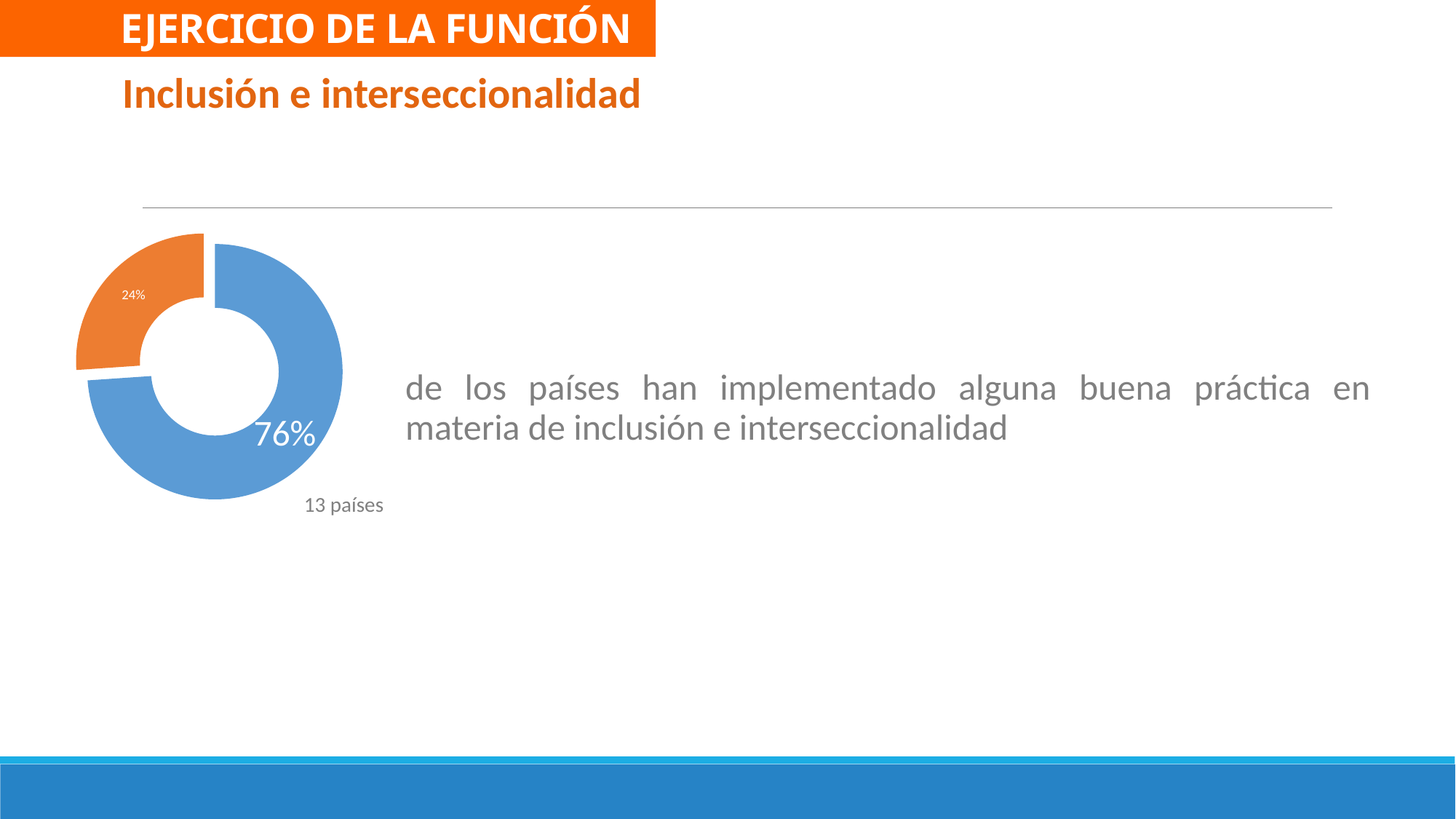
What percentage is shown on the blue slice of the doughnut chart? 76% Which slice of the doughnut chart is the largest? the blue slice (76%) What share of the doughnut does the orange slice represent? 24% How many slices does the doughnut chart have? 2 What is the total of the two slice percentages in the doughnut chart? 100% What colour is the slice labelled 76%? blue What percentage is shown on the orange slice of the doughnut chart? 24% What text label appears below the doughnut chart? 13 países What is the difference in percentage points between the blue slice and the orange slice? 52 What kind of chart is shown on the slide? doughnut chart Is the blue slice or the orange slice larger? the blue slice Which slice of the doughnut chart is the smallest? the orange slice (24%)